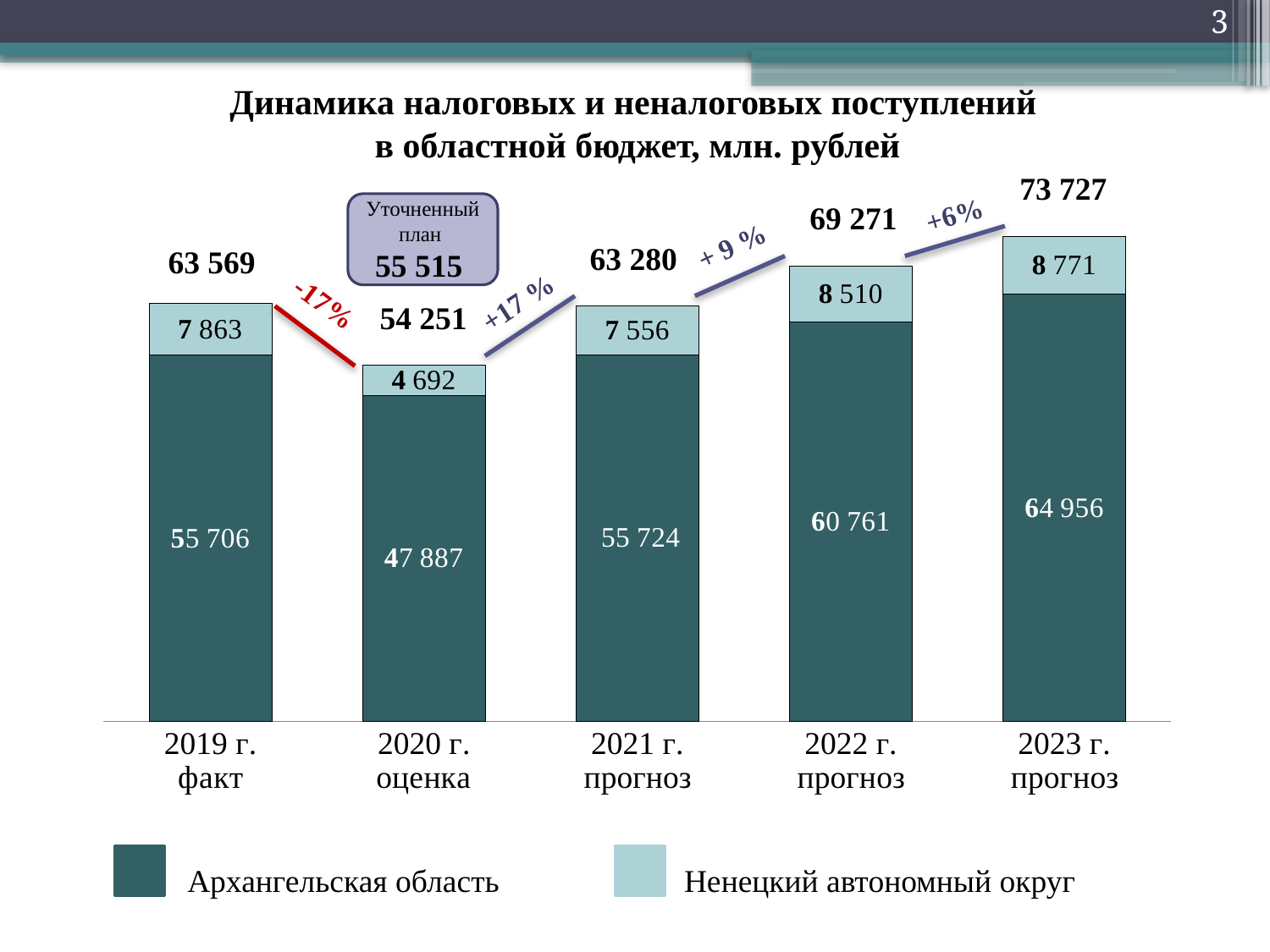
Do the stacked bar totals rise or fall from 2020 г. оценка to 2023 г. прогноз? Rise Which is larger: the Ненецкий автономный округ value in 2019 г. факт or in 2021 г. прогноз? 2019 г. факт What is the value for Архангельская область in 2019 г. факт? 55 706 What percentage change is shown between 2019 г. факт and 2020 г. оценка? -17% Which year has the lowest total of the stacked bar? 2020 г. оценка What is the value for Ненецкий автономный округ in 2023 г. прогноз? 8 771 Which year has the highest value for Архангельская область? 2023 г. прогноз How many series does the legend list? 2 What kind of chart is shown on the slide? Stacked bar chart What is the difference between the Архангельская область values for 2023 г. прогноз and 2022 г. прогноз? 4 195 How many categories (years) are shown on the x axis? 5 What is the total of the stacked bar for 2022 г. прогноз? 69 271